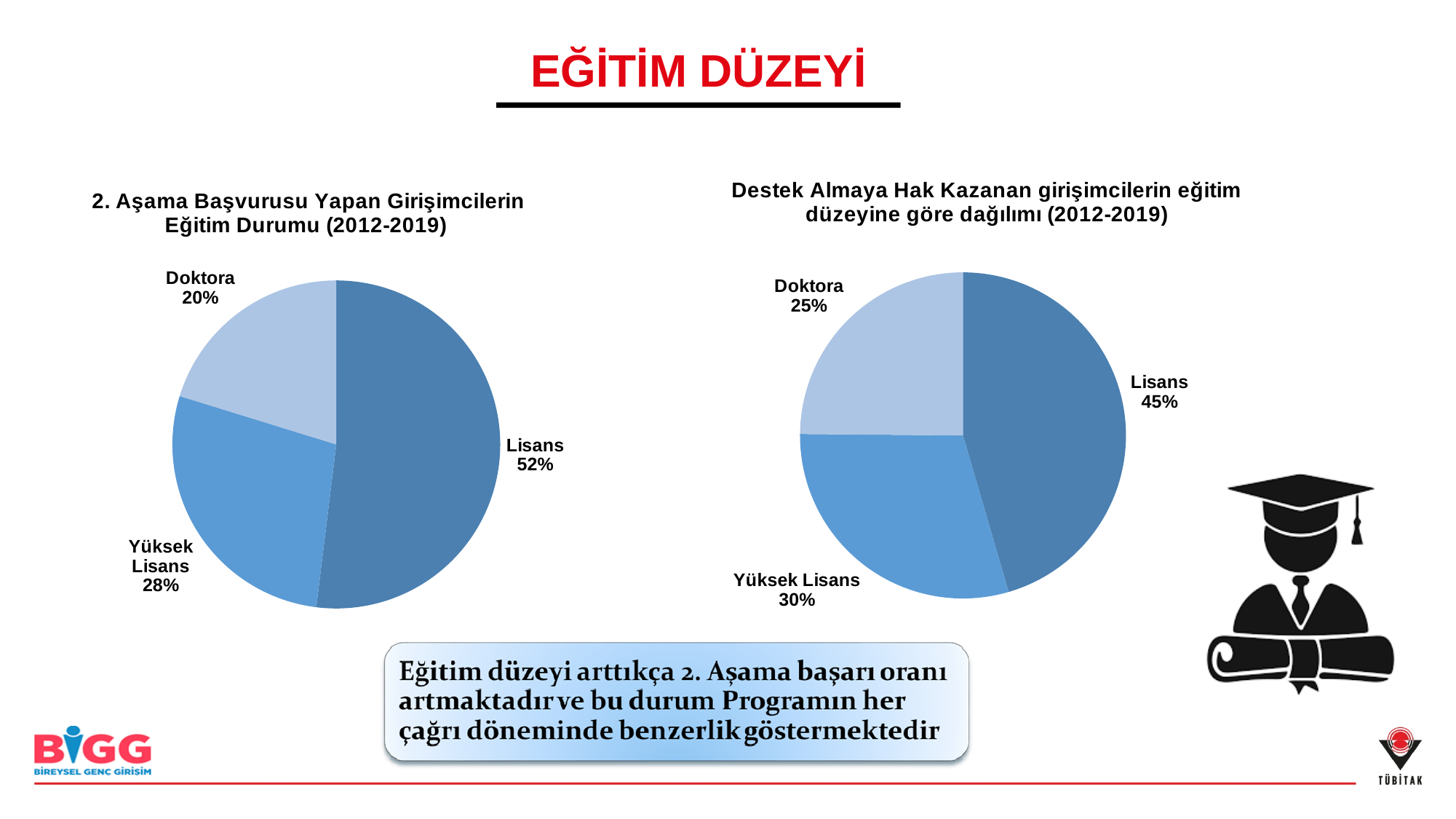
In the left chart (2. Aşama Başvurusu Yapan Girişimcilerin Eğitim Durumu), what is the share for Lisans? 52% What type of chart is the right chart (Destek Almaya Hak Kazanan girişimcilerin eğitim düzeyine göre dağılımı)? Pie chart In the right chart (Destek Almaya Hak Kazanan girişimcilerin eğitim düzeyine göre dağılımı), what is the share for Doktora? 25% In the right chart (Destek Almaya Hak Kazanan girişimcilerin eğitim düzeyine göre dağılımı), which category has the smallest slice? Doktora In the left chart (2. Aşama Başvurusu Yapan Girişimcilerin Eğitim Durumu), what is the difference between the Lisans and Yüksek Lisans shares? 24% In the left chart (2. Aşama Başvurusu Yapan Girişimcilerin Eğitim Durumu), which category has the largest slice? Lisans In the right chart (Destek Almaya Hak Kazanan girişimcilerin eğitim düzeyine göre dağılımı), what is the difference between the Lisans and Doktora shares? 20% Is the Doktora share larger in the left chart or in the right chart? Right chart In the left chart (2. Aşama Başvurusu Yapan Girişimcilerin Eğitim Durumu), what is the share for Doktora? 20% How many categories does the left chart (2. Aşama Başvurusu Yapan Girişimcilerin Eğitim Durumu) show? 3 What is the title of the left chart? 2. Aşama Başvurusu Yapan Girişimcilerin Eğitim Durumu (2012-2019) In the right chart (Destek Almaya Hak Kazanan girişimcilerin eğitim düzeyine göre dağılımı), what is the share for Yüksek Lisans? 30%